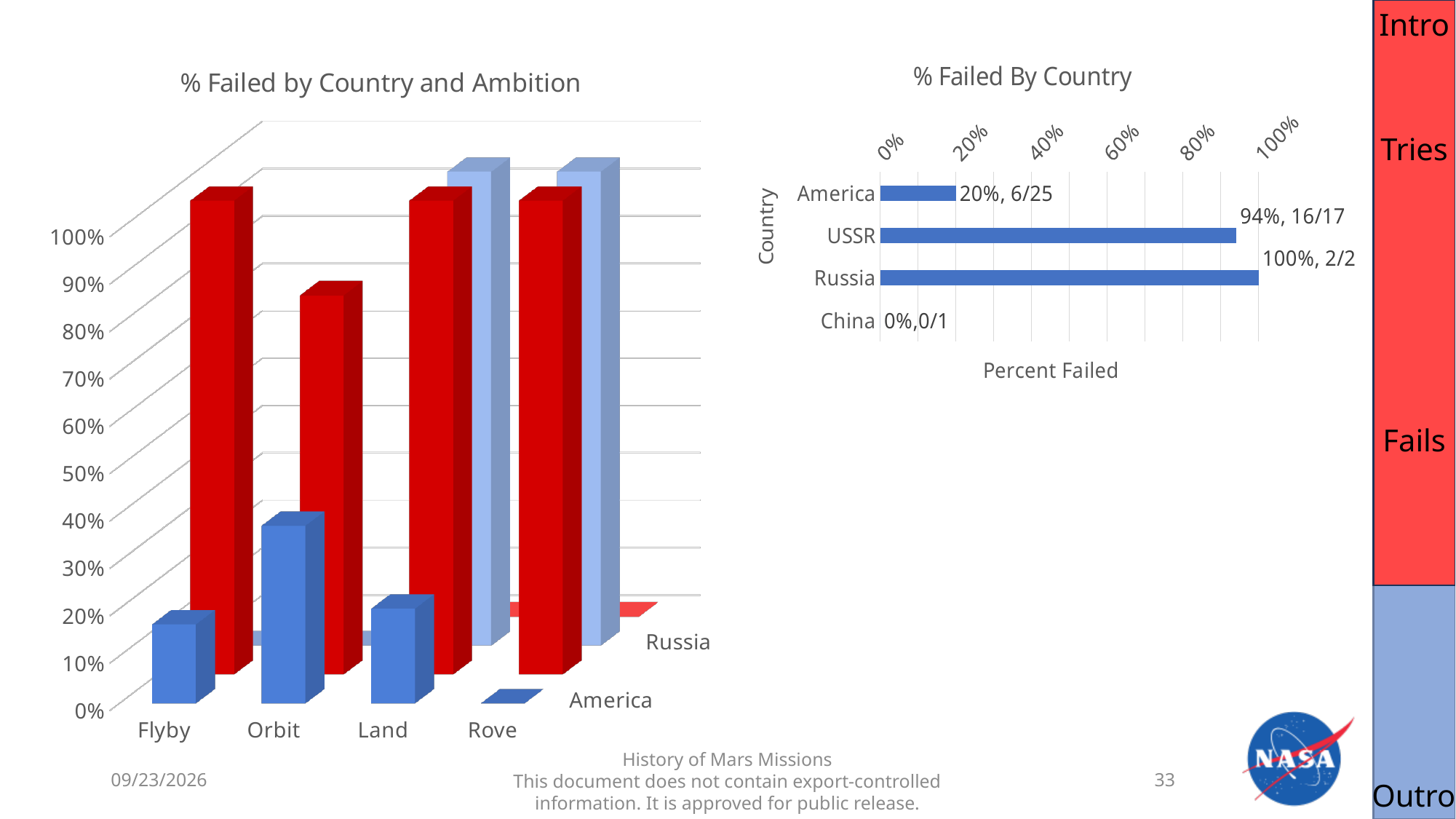
In the '% Failed By Country' chart, what is the value for America? 20%, 6/25 In the '% Failed By Country' chart, what is the value for China? 0%,0/1 In the '% Failed By Country' chart, what is the value for Russia? 100%, 2/2 In the '% Failed By Country' chart, what is the difference in percent failed between Russia and America? 80% How many ambition categories are shown on the x axis of the '% Failed by Country and Ambition' chart? 4 In the '% Failed By Country' chart, which has a higher percent failed, USSR or America? USSR In the '% Failed By Country' chart, which country has the highest percent failed? Russia How many countries are shown in the '% Failed By Country' chart? 4 In the '% Failed By Country' chart, what is the value for USSR? 94%, 16/17 What is the title of the x axis in the '% Failed By Country' chart? Percent Failed In the '% Failed By Country' chart, which country has the lowest percent failed? China What kind of chart is the '% Failed by Country and Ambition' chart? Bar chart